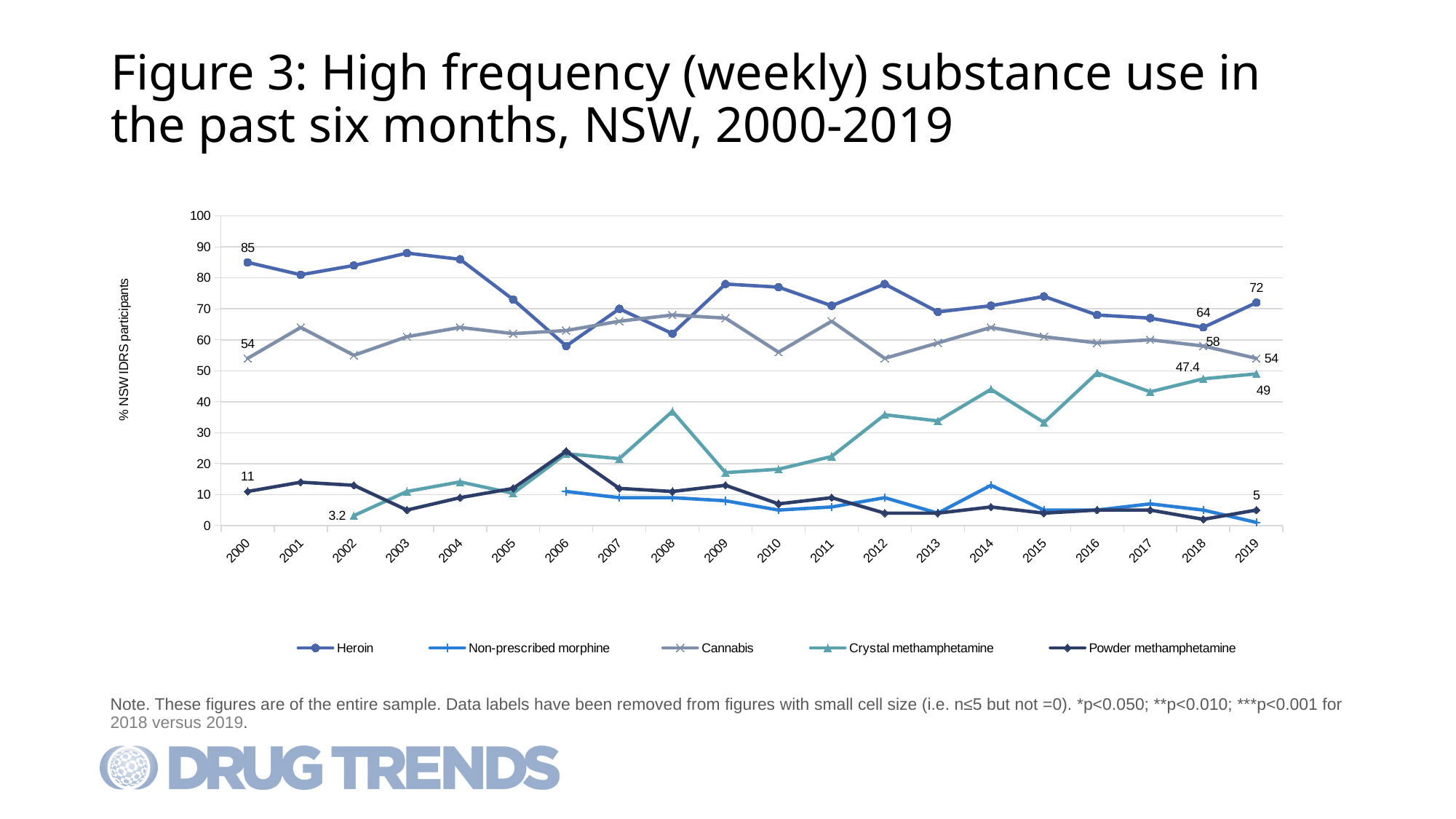
In 2019, which is larger: the value for Heroin or the value for Cannabis? Heroin What kind of chart is shown on the slide? line chart How many years are shown on the x axis? 20 What is the value for Heroin in 2019? 72 Is the value for Crystal methamphetamine in 2008 greater or less than 30? greater What is the difference between the Cannabis values in 2018 and 2019? 4 What is the value for Heroin in 2000? 85 What is the value for Crystal methamphetamine in 2018? 47.4 By how much did the Heroin value change from 2018 to 2019? 8 What is the value for Powder methamphetamine in 2019? 5 What is the value for Crystal methamphetamine in 2002? 3.2 How many series does the legend list? 5